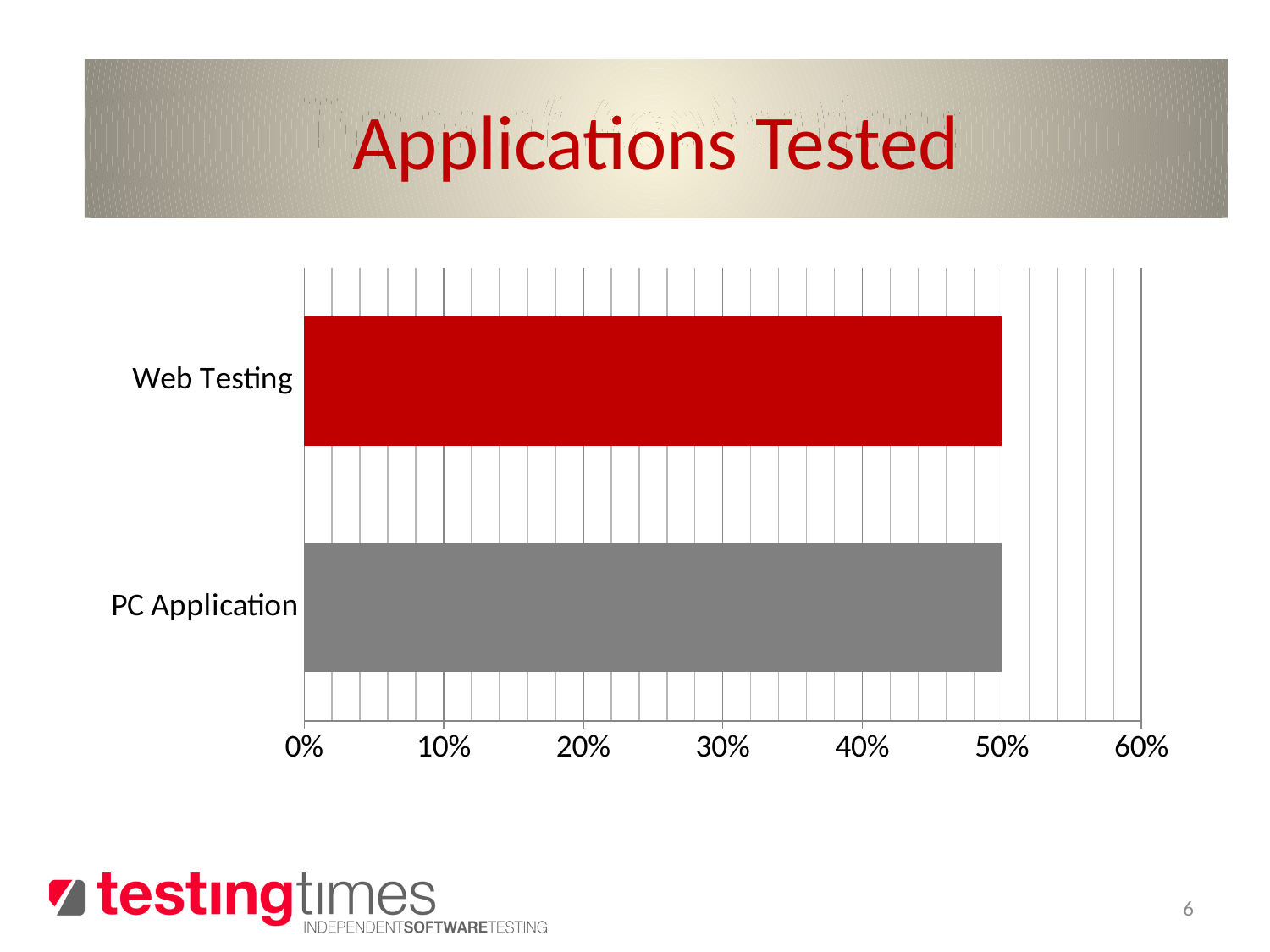
Is the value for PC Application greater or less than 60%? less What kind of chart is shown on the slide? bar chart Is the value for Web Testing greater or less than 40%? greater What is the title of the chart? Applications Tested What is the highest value shown on the x axis? 60% How many categories are plotted in the chart? 2 What colour is the bar for Web Testing? red What is the value for Web Testing? 50% What is the difference between the values for Web Testing and PC Application? 0% Is the value for PC Application greater or less than 30%? greater What is the value for PC Application? 50%